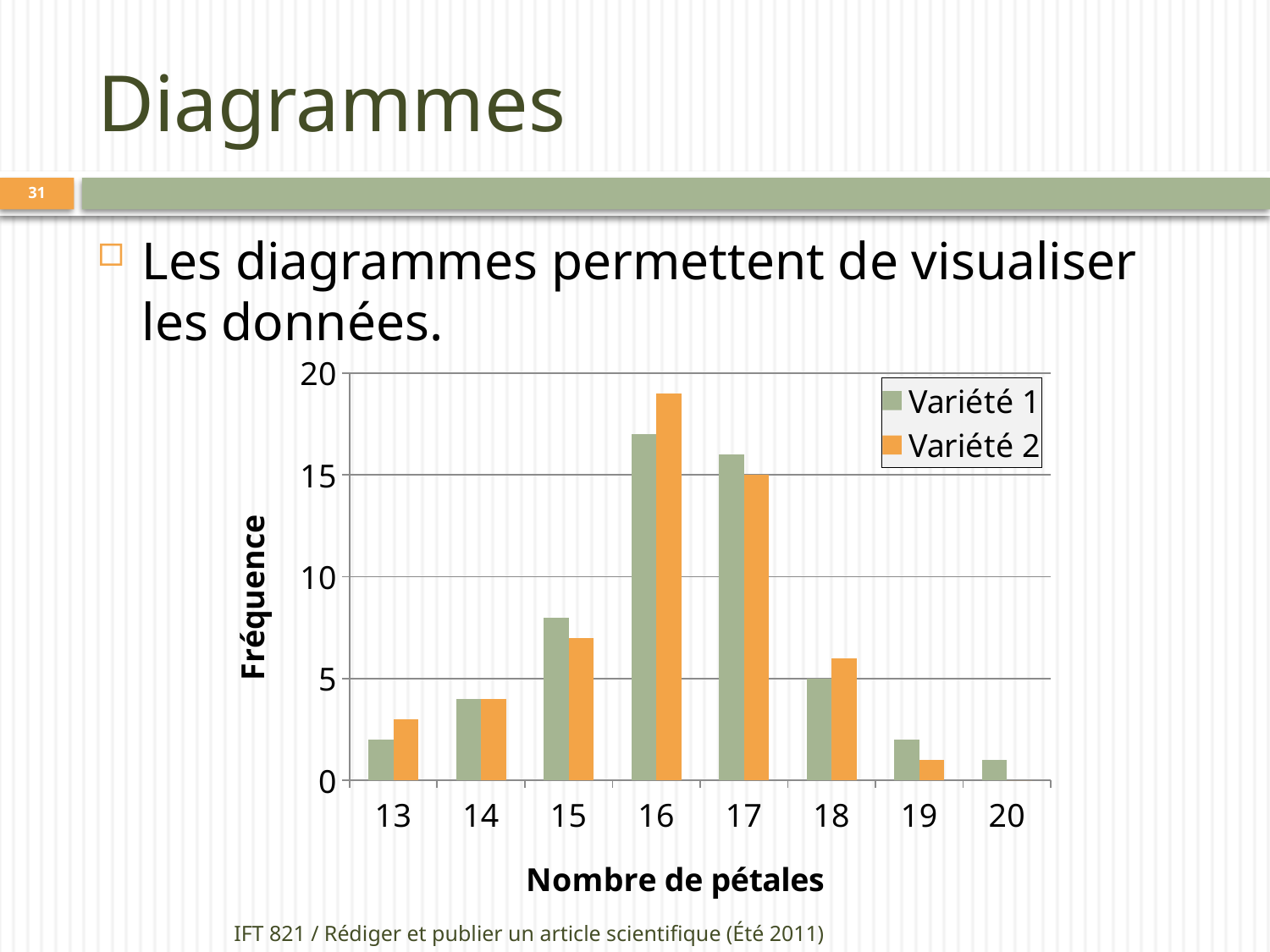
Is the value for Variété 1 at 13 petals greater or less than 5? less For which number of petals is the Variété 1 frequency highest? 16 For which number of petals is the Variété 2 frequency highest? 16 How many series does the legend list? 2 How many categories are shown on the x axis? 8 What kind of chart is shown on the slide? bar chart What is the value for Variété 2 at 17 petals? 15 For which number of petals is the Variété 1 frequency lowest? 20 What is the title of the x axis? Nombre de pétales What is the value for Variété 1 at 18 petals? 5 At 16 petals, which series has the larger value, Variété 1 or Variété 2? Variété 2 Is the value for Variété 2 at 16 petals greater or less than 15? greater